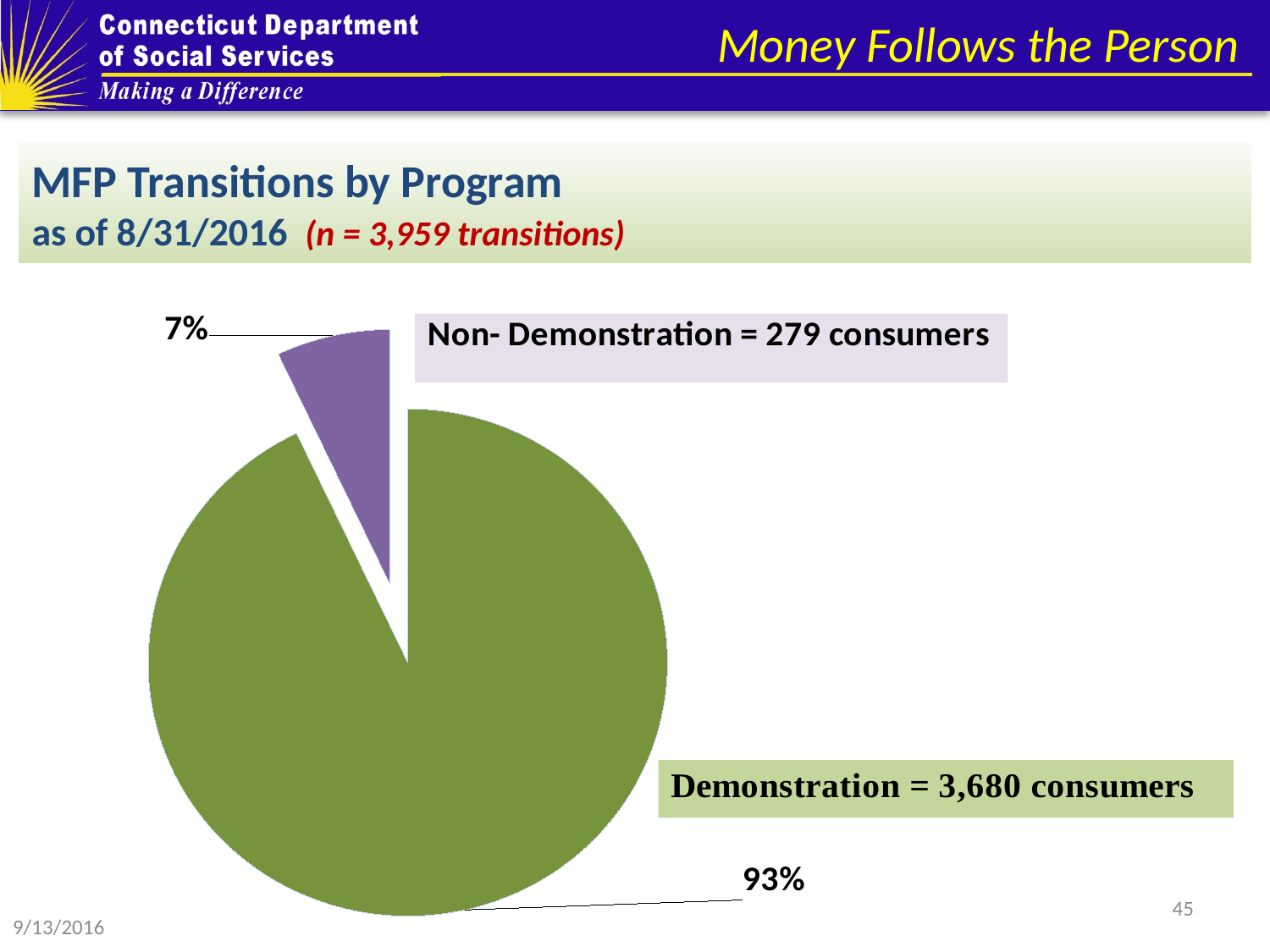
What is the difference in consumers between the Demonstration and Non-Demonstration programs? 3,401 How many consumers are in the Demonstration program? 3,680 consumers How many slices does the pie chart have? 2 Which program has the smaller share of MFP transitions? Non-Demonstration What percentage of MFP transitions does the Demonstration slice represent? 93% What percentage of MFP transitions does the Non-Demonstration slice represent? 7% How many consumers are in the Non-Demonstration program? 279 consumers What kind of chart is shown on the slide? pie chart What is the total number of transitions shown in the chart title? 3,959 transitions What colour is the Demonstration slice of the pie chart? green Which program has the larger share of MFP transitions? Demonstration Is the Demonstration share larger or smaller than the Non-Demonstration share? larger